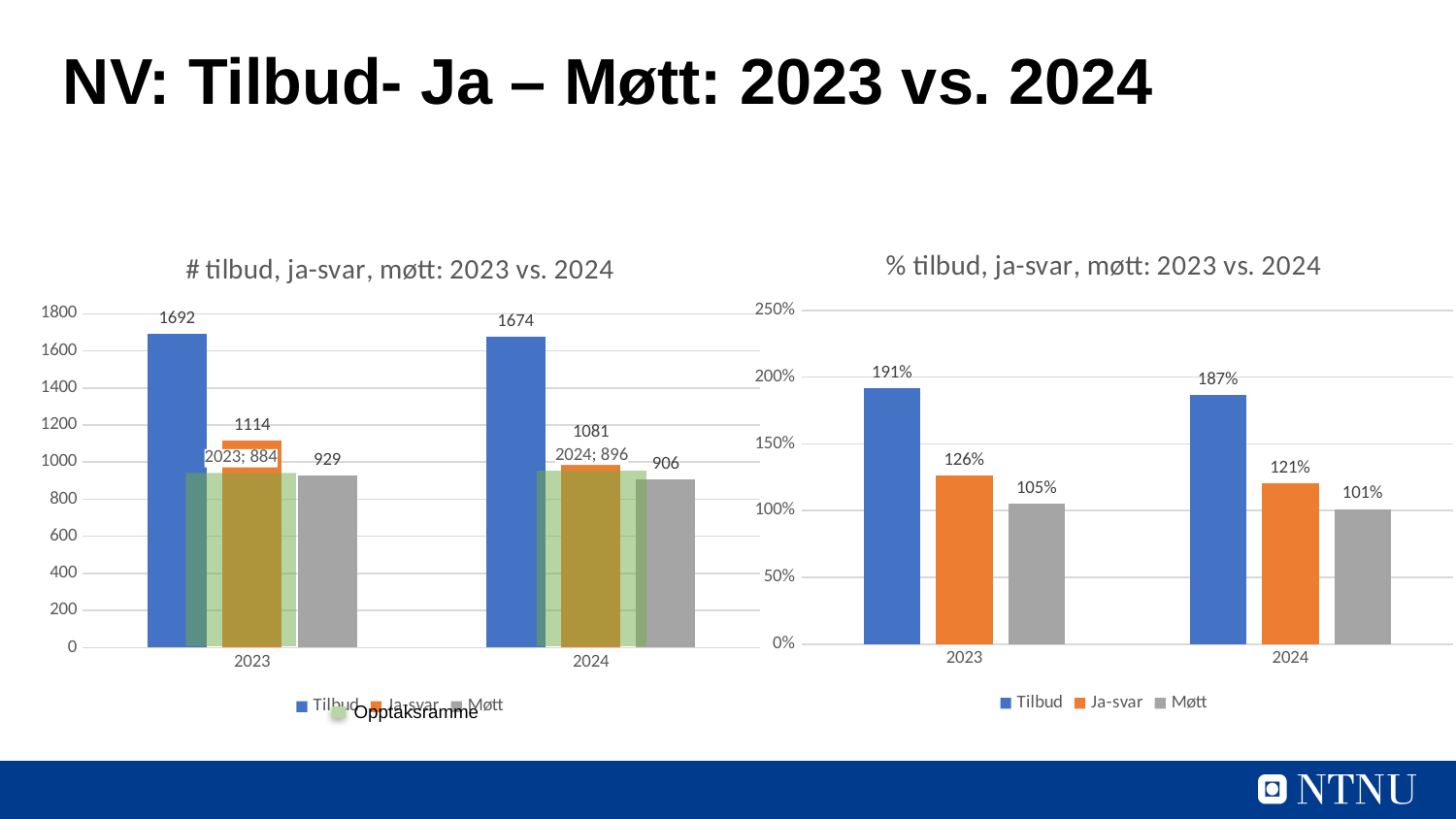
In the chart titled "# tilbud, ja-svar, møtt: 2023 vs. 2024", what is the difference between Tilbud in 2023 and Tilbud in 2024? 18 In the chart titled "# tilbud, ja-svar, møtt: 2023 vs. 2024", which is larger: Møtt in 2023 or Møtt in 2024? Møtt in 2023 In the chart titled "# tilbud, ja-svar, møtt: 2023 vs. 2024", what is the value of Møtt for 2023? 929 In the chart titled "% tilbud, ja-svar, møtt: 2023 vs. 2024", what is the value of Møtt for 2024? 101% In the chart titled "% tilbud, ja-svar, møtt: 2023 vs. 2024", what is the value of Tilbud for 2023? 191% In the chart titled "# tilbud, ja-svar, møtt: 2023 vs. 2024", what is the Opptaksramme value shown for 2024? 896 What type of chart is the chart titled "% tilbud, ja-svar, møtt: 2023 vs. 2024"? Bar chart In the chart titled "% tilbud, ja-svar, møtt: 2023 vs. 2024", which series has the lowest value in 2023? Møtt In the chart titled "% tilbud, ja-svar, møtt: 2023 vs. 2024", what is the difference between Ja-svar in 2023 and Ja-svar in 2024? 5% In the chart titled "# tilbud, ja-svar, møtt: 2023 vs. 2024", what is the value of Tilbud for 2023? 1692 In the chart titled "# tilbud, ja-svar, møtt: 2023 vs. 2024", what is the value of Ja-svar for 2024? 1081 How many series does the legend of the chart titled "% tilbud, ja-svar, møtt: 2023 vs. 2024" list? 3